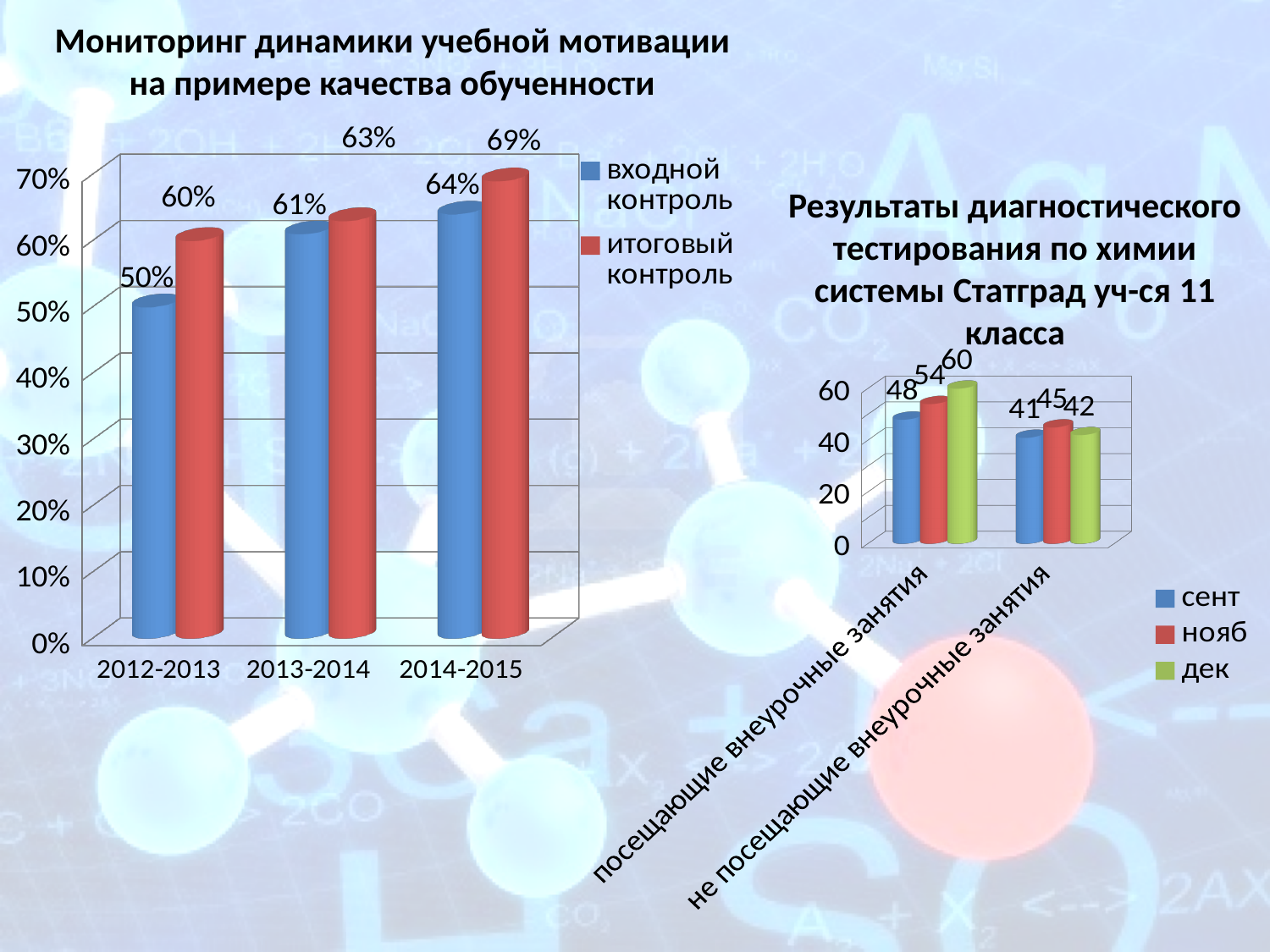
In the right chart (Результаты диагностического тестирования по химии), what is the difference between дек and сент for посещающие внеурочные занятия? 12 In the left chart (Мониторинг динамики учебной мотивации), which year has the highest итоговый контроль value? 2014-2015 In the left chart (Мониторинг динамики учебной мотивации), what is the value of итоговый контроль for 2014-2015? 69% In the right chart (Результаты диагностического тестирования по химии), what is the value of сент for не посещающие внеурочные занятия? 41 In the right chart (Результаты диагностического тестирования по химии), how many series does the legend list? 3 In the right chart (Результаты диагностического тестирования по химии), what is the value of дек for посещающие внеурочные занятия? 60 In the right chart (Результаты диагностического тестирования по химии), which is larger: нояб for посещающие внеурочные занятия or нояб for не посещающие внеурочные занятия? посещающие внеурочные занятия In the left chart (Мониторинг динамики учебной мотивации), does the входной контроль value rise or fall from 2012-2013 to 2014-2015? rise In the left chart (Мониторинг динамики учебной мотивации), what is the difference between итоговый контроль and входной контроль for 2012-2013? 10% In the left chart (Мониторинг динамики учебной мотивации), what kind of chart is it? bar chart In the left chart (Мониторинг динамики учебной мотивации), what is the value of входной контроль for 2012-2013? 50% In the left chart (Мониторинг динамики учебной мотивации), how many series does the legend list? 2